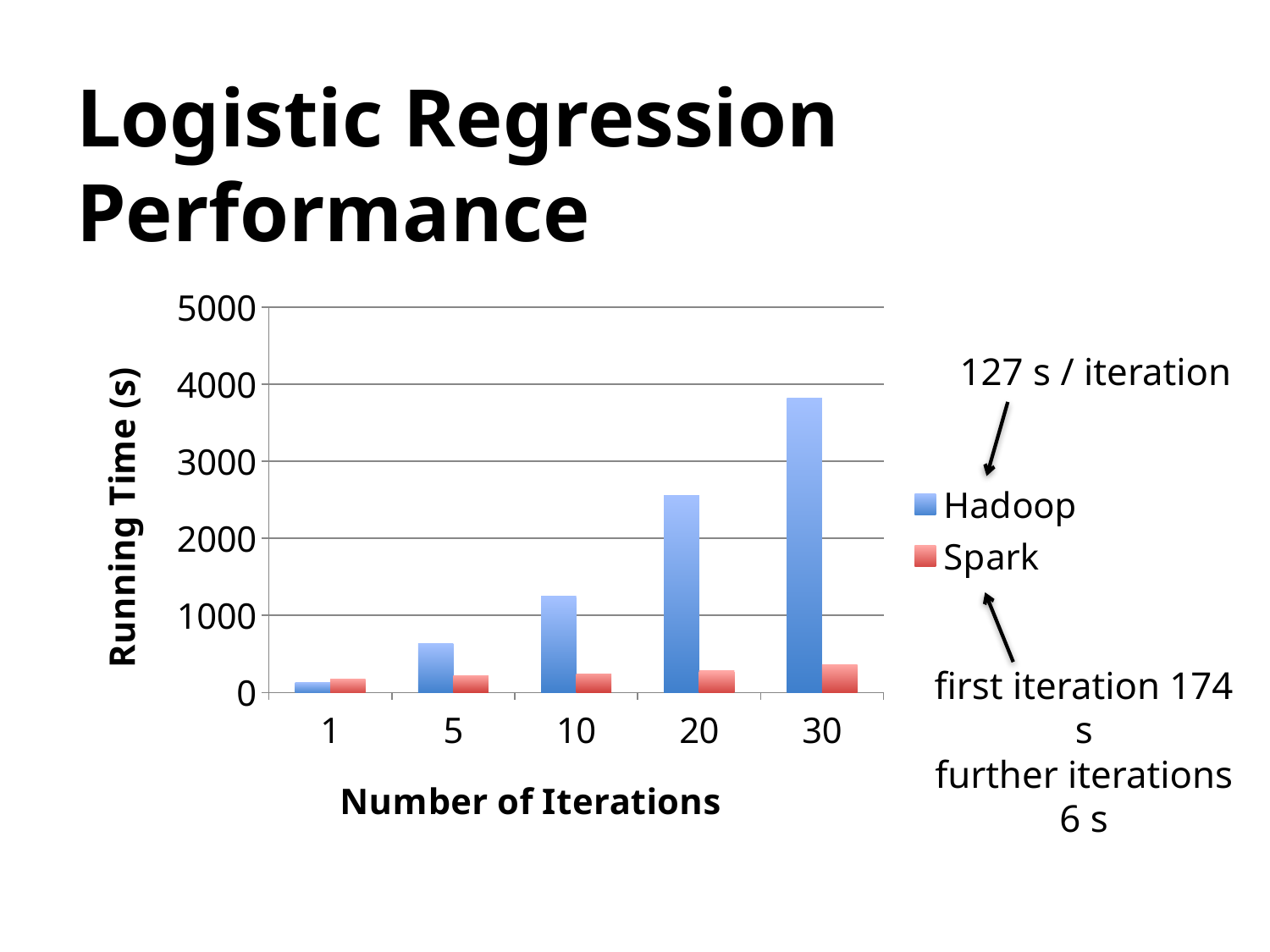
Is the Hadoop running time at 30 iterations greater or less than 3000? greater How many series does the legend list? 2 How many iteration counts are shown on the x axis? 5 At which number of iterations is the Hadoop running time highest? 30 At 30 iterations, which has the larger running time, Hadoop or Spark? Hadoop What kind of chart is shown on the slide? bar chart Is the Spark running time at 30 iterations greater or less than 1000? less Is the Hadoop running time at 5 iterations greater or less than 1000? less Does the Hadoop running time rise or fall as the number of iterations increases? rise What is the label of the y axis? Running Time (s) At which number of iterations is the Hadoop running time lowest? 1